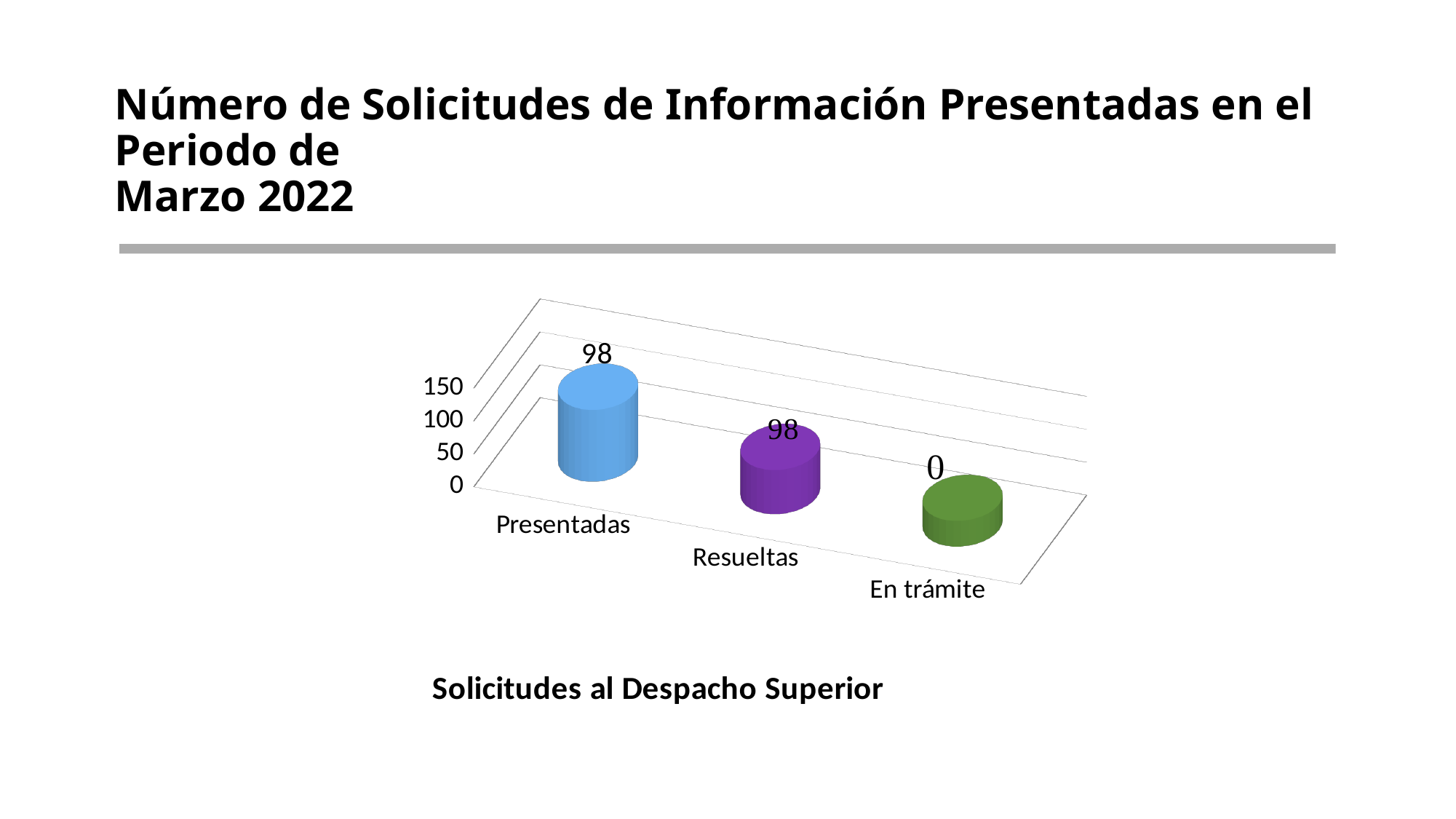
What is the title shown below the chart? Solicitudes al Despacho Superior Which category has the lowest value? En trámite What kind of chart is shown on the slide? bar chart Is the value for Resueltas greater or less than 100? less Is the value for Presentadas greater or less than 50? greater Which is larger, the value for Resueltas or the value for En trámite? Resueltas How many categories are shown in the chart? 3